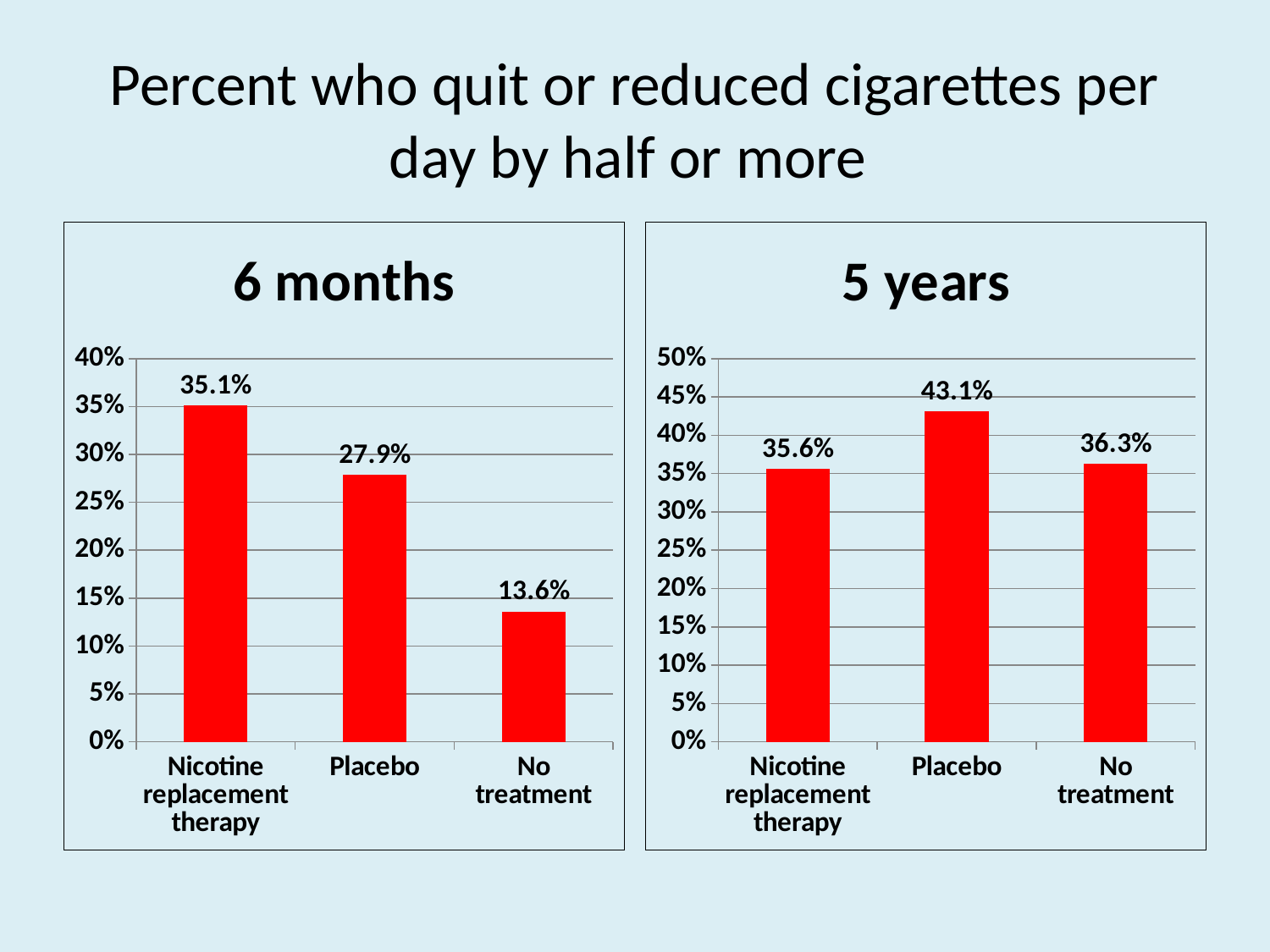
In the '6 months' chart, what is the difference between the Placebo value and the No treatment value? 14.3% In the '6 months' chart, what is the value for Nicotine replacement therapy? 35.1% In the '5 years' chart, what is the value for Nicotine replacement therapy? 35.6% In the '5 years' chart, which category has the lowest value? Nicotine replacement therapy In the '6 months' chart, do the values rise or fall from left to right across the categories? fall What kind of chart is the '6 months' chart? bar chart In the '6 months' chart, which category has the highest value? Nicotine replacement therapy In the '5 years' chart, what is the value for Placebo? 43.1% In the '6 months' chart, what is the value for No treatment? 13.6% How many categories are shown in the '5 years' chart? 3 In the '5 years' chart, what is the difference between the Placebo value and the No treatment value? 6.8% In the '6 months' chart, which is larger, the value for Placebo or the value for No treatment? Placebo